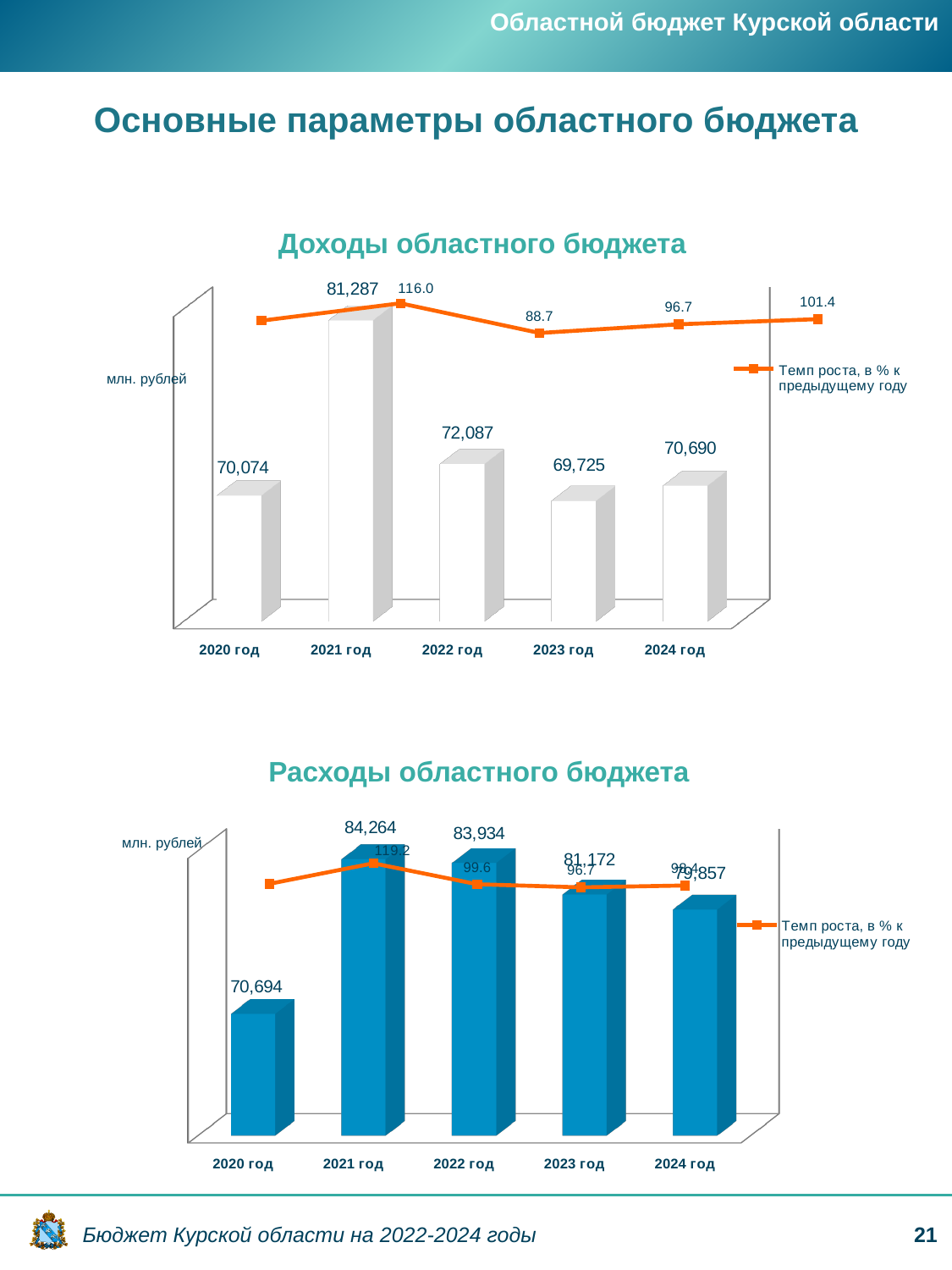
In the chart "Расходы областного бюджета", do the bar values rise or fall from 2021 год to 2024 год? fall In the chart "Доходы областного бюджета", what is the value for 2021 год? 81,287 In the chart "Расходы областного бюджета", what is the growth rate (Темп роста) value shown for 2021 год? 119.2 What unit is indicated on the y axis of the chart "Расходы областного бюджета"? млн. рублей In the chart "Доходы областного бюджета", which year has the highest bar? 2021 год In the chart "Расходы областного бюджета", what is the value for 2020 год? 70,694 In the chart "Доходы областного бюджета", what is the difference between the 2021 год and 2020 год bar values? 11,213 In the chart "Расходы областного бюджета", which is larger: the bar for 2022 год or the bar for 2024 год? 2022 год In the chart "Доходы областного бюджета", what is the growth rate (Темп роста) value shown for 2022 год? 88.7 In the chart "Расходы областного бюджета", which year has the highest bar? 2021 год How many years are shown on the x axis of the chart "Доходы областного бюджета"? 5 In the chart "Доходы областного бюджета", which year has the lowest bar? 2023 год